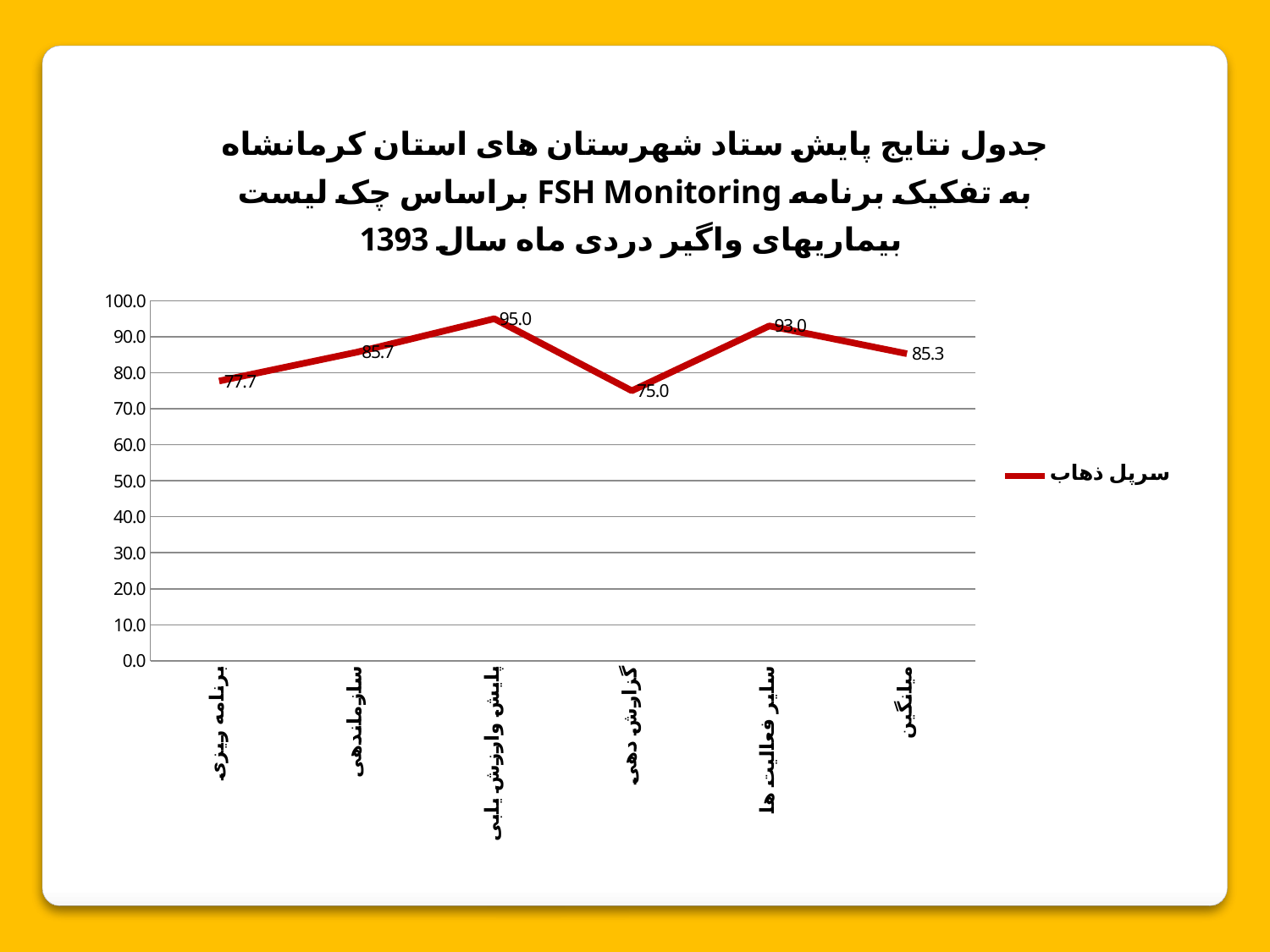
What is the value for میانگین? 85.3 Which is larger, the value for برنامه ریزی or the value for سایر فعالیت ها? سایر فعالیت ها What is the difference between the values for سایر فعالیت ها and گزارش دهی? 18.0 Which category has the lowest value? گزارش دهی What is the value for گزارش دهی? 75.0 What is the value for سایر فعالیت ها? 93.0 What is the value for سازماندهی? 85.7 How many categories are plotted along the x axis? 6 What series name does the legend show? سرپل ذهاب What is the value for برنامه ریزی? 77.7 What kind of chart is shown on the slide? line chart What is the highest value plotted on the chart? 95.0